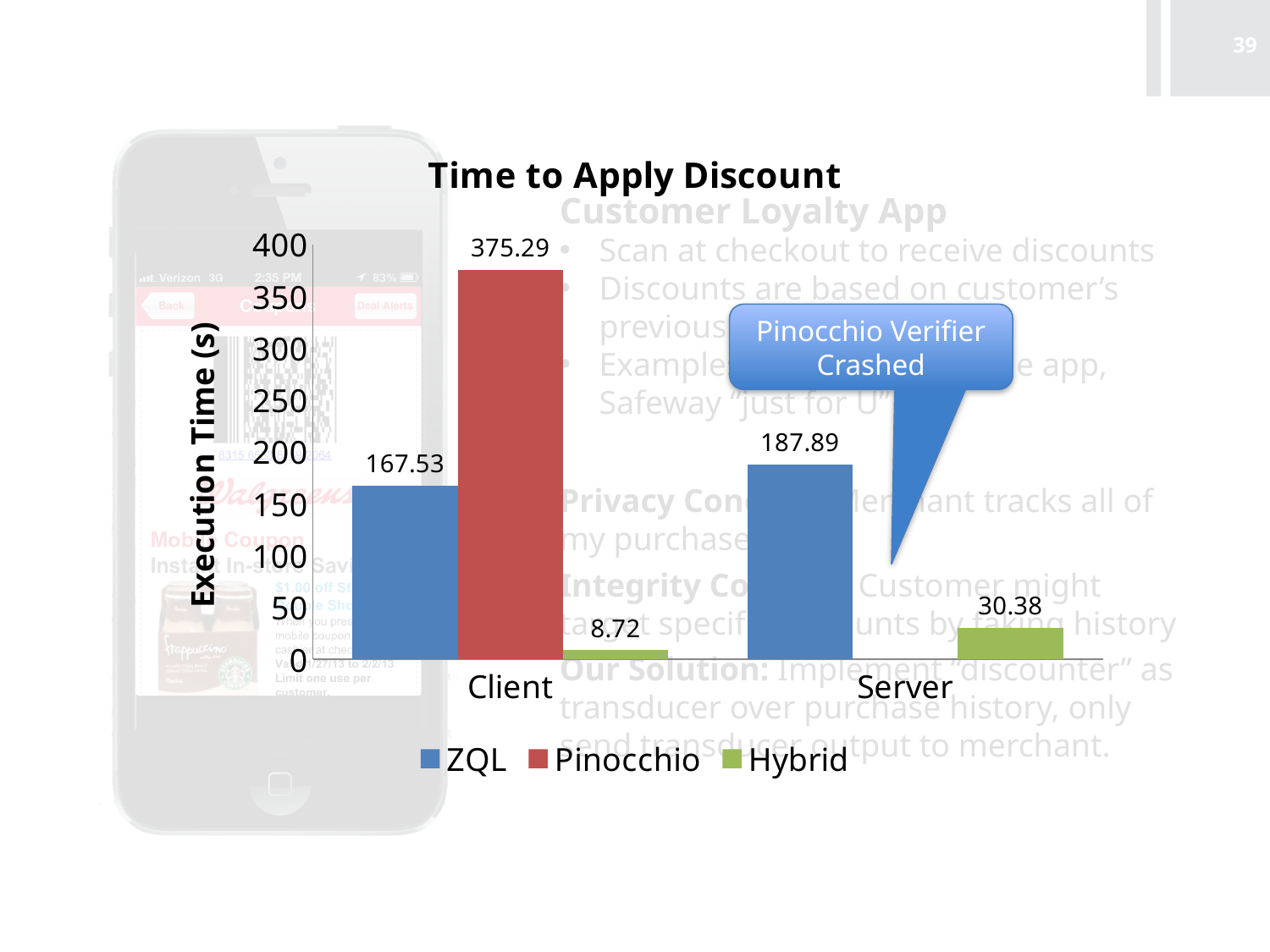
What is the difference between the ZQL execution times for Server and Client? 20.36 What is the execution time for Hybrid on the Client? 8.72 What is the execution time for ZQL on the Server? 187.89 What is the execution time for Pinocchio on the Client? 375.29 What kind of chart is shown on the slide? bar chart Which is larger, the ZQL execution time on the Client or on the Server? Server What is the execution time for Hybrid on the Server? 30.38 Why is there no Pinocchio bar for the Server category? Pinocchio Verifier Crashed Which series has the highest execution time for the Client? Pinocchio Which series has the lowest execution time for the Server? Hybrid How many series does the legend list? 3 What is the title of the chart? Time to Apply Discount